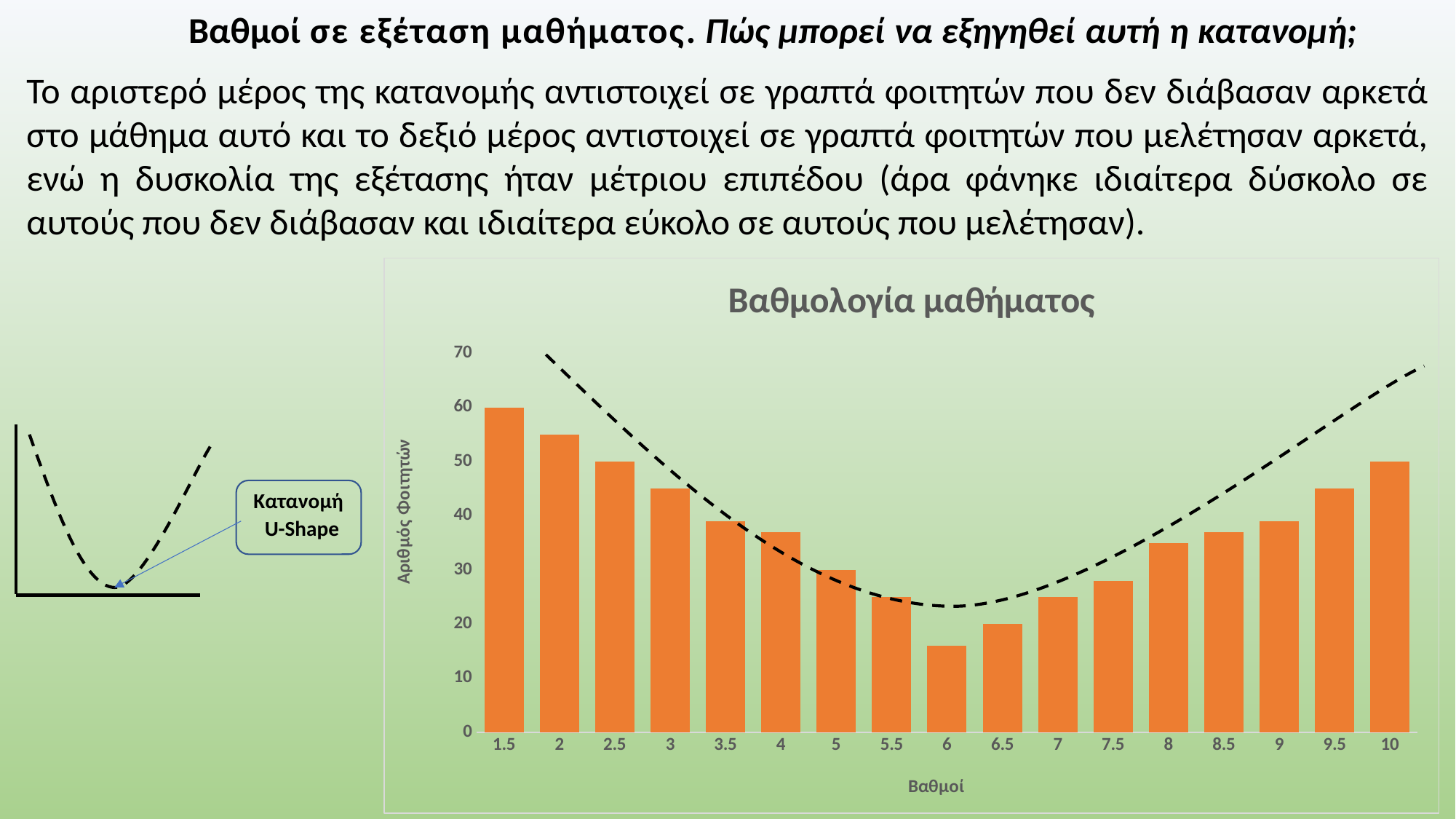
What kind of chart is shown on the slide? bar chart What is the label of the vertical axis of the chart? Αριθμός Φοιτητών Which grade category has the lowest number of students? 6 What is the number of students for grade 1.5? 60 What is the title of the chart? Βαθμολογία μαθήματος Which grade category has the highest number of students? 1.5 How do the values change along the x axis from grade 1.5 to grade 10? they fall to a minimum at 6 and then rise How many grade categories are shown on the x axis of the chart? 17 Is the number of students for grade 9.5 greater or less than 40? greater Which has more students, grade 2 or grade 10? grade 2 Is the number of students for grade 6 greater or less than 20? less